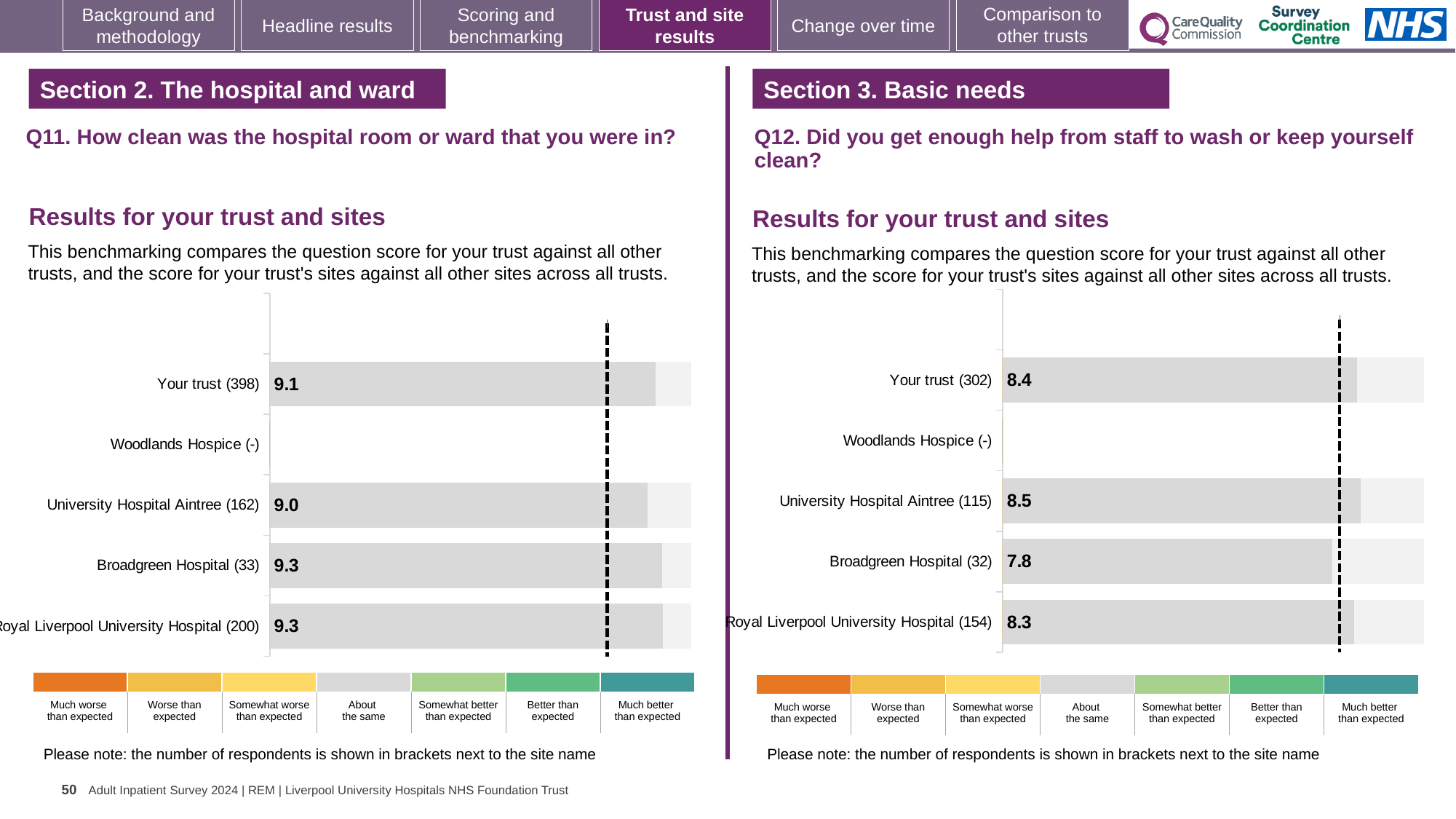
In the Q12 chart (right), which has the larger score, Your trust or Royal Liverpool University Hospital? Your trust In the Q12 chart (right), what is the score for Royal Liverpool University Hospital? 8.3 What kind of chart is used for the Q12 results (right)? Bar chart In the Q11 chart (left), which site has the lowest score among those with a plotted bar? University Hospital Aintree In the Q12 chart (right), what is the score for Broadgreen Hospital? 7.8 How many categories (rows) are listed on the y axis of the Q11 chart (left)? 5 In the Q11 chart (left), what is the difference between the scores for Broadgreen Hospital and University Hospital Aintree? 0.3 In the Q11 chart (left), what is the score for Your trust? 9.1 In the Q11 chart (left), what is the score for University Hospital Aintree? 9.0 In the Q12 chart (right), what is the difference between the scores for University Hospital Aintree and Broadgreen Hospital? 0.7 In the Q12 chart (right), which site has the highest score? University Hospital Aintree In the Q12 chart (right), which site has the lowest score? Broadgreen Hospital